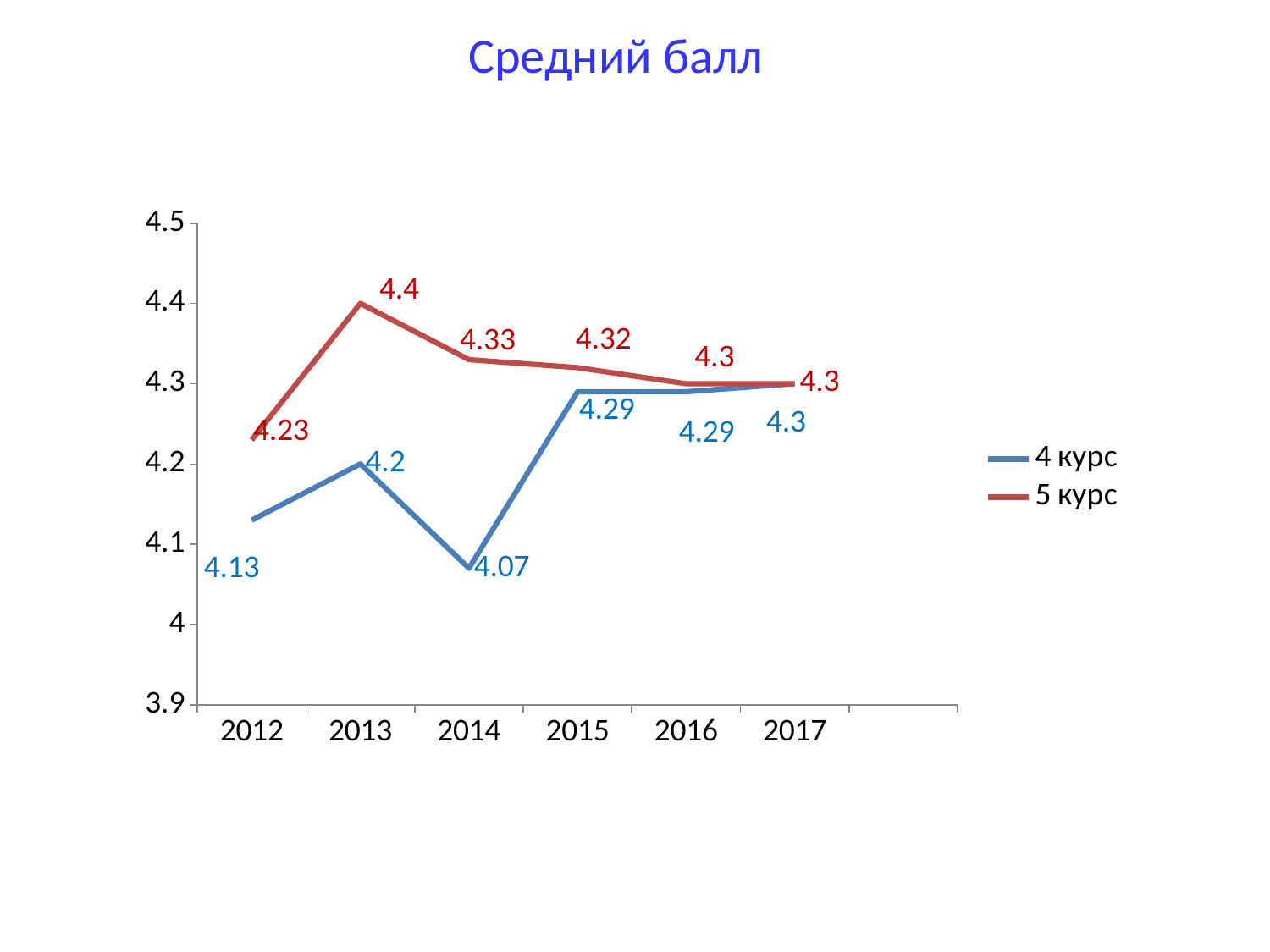
How many years are shown on the x axis? 6 In which year is the 4 курс value lowest? 2014 What is the title of the chart? Средний балл What is the value for 5 курс in 2015? 4.32 Which series has the larger value in 2014, 4 курс or 5 курс? 5 курс How many series does the legend list? 2 In which year is the 5 курс value highest? 2013 What kind of chart is shown on the slide? Line chart What is the difference between the 5 курс and 4 курс values in 2013? 0.2 What is the value for 5 курс in 2013? 4.4 What is the value for 4 курс in 2012? 4.13 What is the value for 4 курс in 2014? 4.07